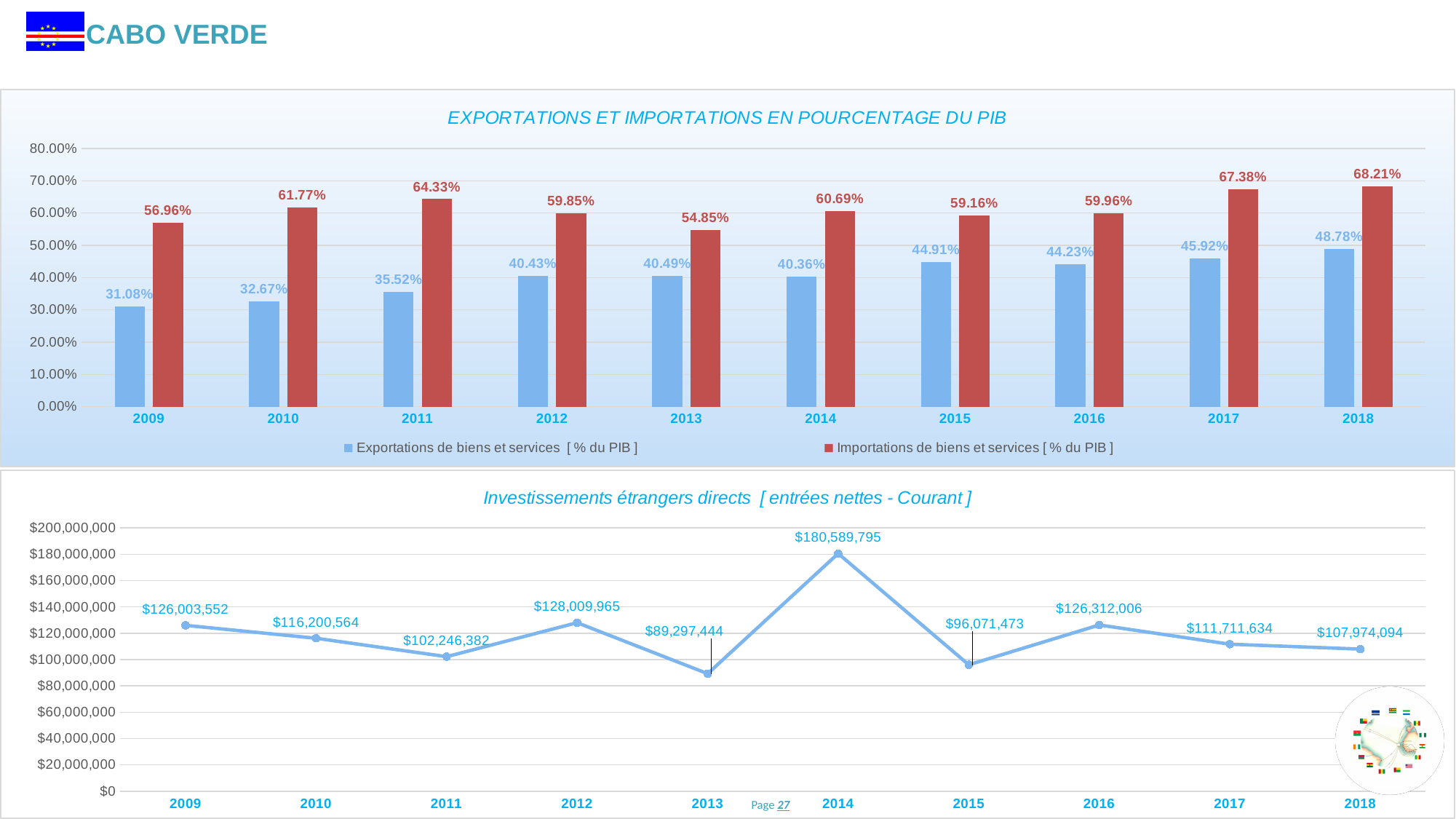
In the chart titled 'EXPORTATIONS ET IMPORTATIONS EN POURCENTAGE DU PIB', what is the value of Exportations de biens et services for 2018? 48.78% In the chart titled 'Investissements étrangers directs', which is larger, the value for 2009 or the value for 2016? 2016 In the chart titled 'EXPORTATIONS ET IMPORTATIONS EN POURCENTAGE DU PIB', what kind of chart is it? Bar chart In the chart titled 'Investissements étrangers directs', what kind of chart is it? Line chart In the chart titled 'EXPORTATIONS ET IMPORTATIONS EN POURCENTAGE DU PIB', how many series does the legend list? 2 In the chart titled 'Investissements étrangers directs', how many years are plotted on the x axis? 10 In the chart titled 'EXPORTATIONS ET IMPORTATIONS EN POURCENTAGE DU PIB', which year has the highest Importations value? 2018 In the chart titled 'EXPORTATIONS ET IMPORTATIONS EN POURCENTAGE DU PIB', which year has the lowest Exportations value? 2009 In the chart titled 'EXPORTATIONS ET IMPORTATIONS EN POURCENTAGE DU PIB', what is the value of Importations de biens et services for 2013? 54.85% In the chart titled 'EXPORTATIONS ET IMPORTATIONS EN POURCENTAGE DU PIB', what is the difference between Importations and Exportations in 2011? 28.81% In the chart titled 'Investissements étrangers directs', what is the value for 2014? $180,589,795 In the chart titled 'Investissements étrangers directs', which year has the lowest value? 2013